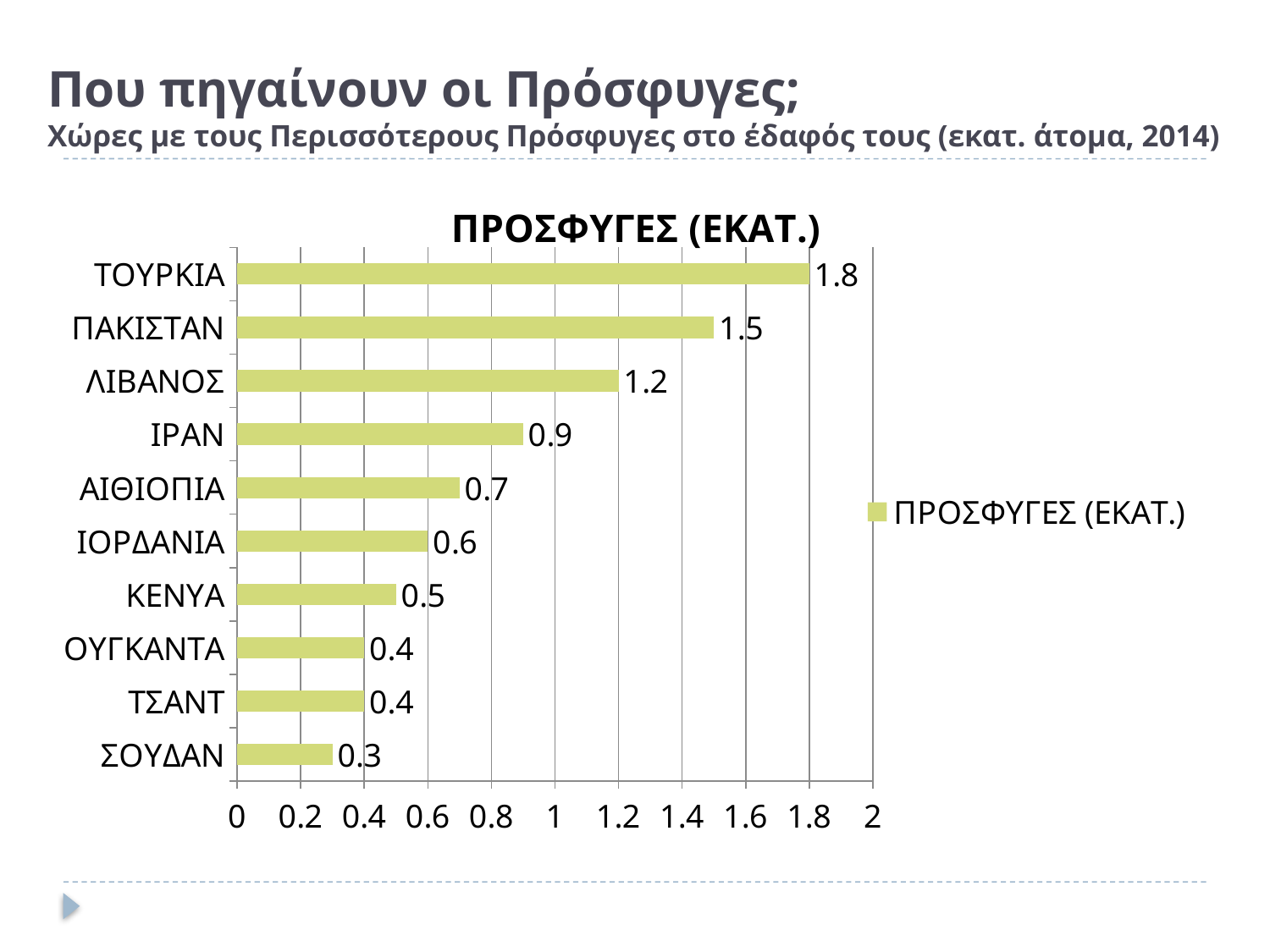
Which country has the lowest value? ΣΟΥΔΑΝ How many series does the legend list? 1 What is the value for ΚΕΝΥΑ? 0.5 Is the value for ΛΙΒΑΝΟΣ greater or less than 1? greater What is the difference between the values for ΠΑΚΙΣΤΑΝ and ΙΡΑΝ? 0.6 What kind of chart is shown on the slide? bar chart What is the value for ΛΙΒΑΝΟΣ? 1.2 How many countries are shown in the chart? 10 What is the value for ΤΟΥΡΚΙΑ? 1.8 Which is larger, the value for ΑΙΘΙΟΠΙΑ or the value for ΙΟΡΔΑΝΙΑ? ΑΙΘΙΟΠΙΑ Which country has the highest value? ΤΟΥΡΚΙΑ What is the title of the chart? ΠΡΟΣΦΥΓΕΣ (ΕΚΑΤ.)